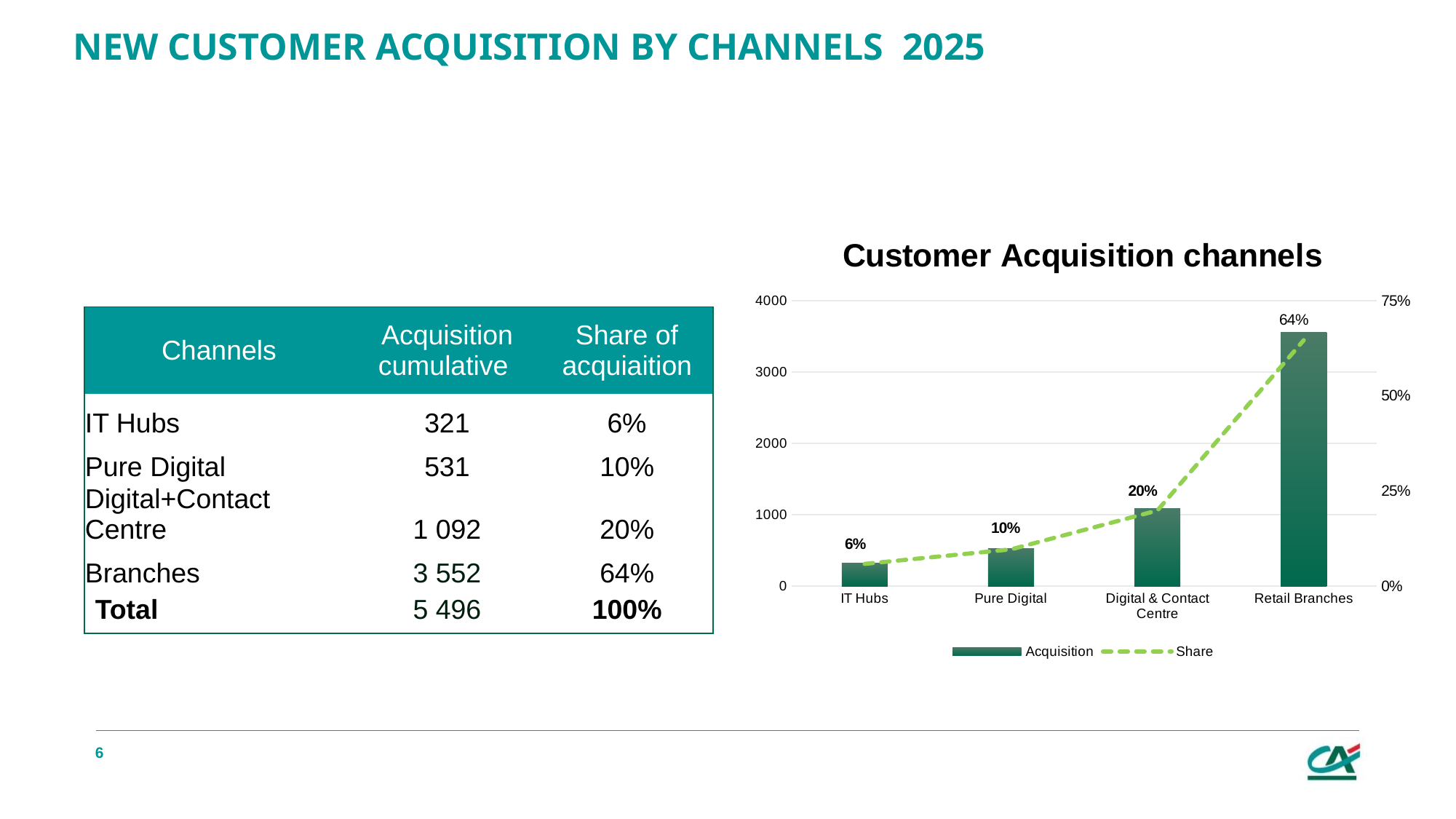
Which channel has the lowest Acquisition bar in the Customer Acquisition channels chart? IT Hubs Which channel has the highest Share in the Customer Acquisition channels chart? Retail Branches In the Customer Acquisition channels chart, is the Acquisition bar for Pure Digital greater or less than 1000? less What is the difference between the Share for Retail Branches and the Share for Pure Digital in the Customer Acquisition channels chart? 54 percentage points What is the Share value for Digital & Contact Centre in the Customer Acquisition channels chart? 20% What is the Share value for IT Hubs in the Customer Acquisition channels chart? 6% Which has a larger Acquisition bar in the Customer Acquisition channels chart, Pure Digital or Digital & Contact Centre? Digital & Contact Centre How many channels are shown on the x axis of the Customer Acquisition channels chart? 4 In the Customer Acquisition channels chart, is the Acquisition bar for Retail Branches greater or less than 3000? greater How many series does the legend of the Customer Acquisition channels chart list? 2 What type of chart is the "Customer Acquisition channels" chart? Bar chart with a line What is the Share value for Retail Branches in the Customer Acquisition channels chart? 64%